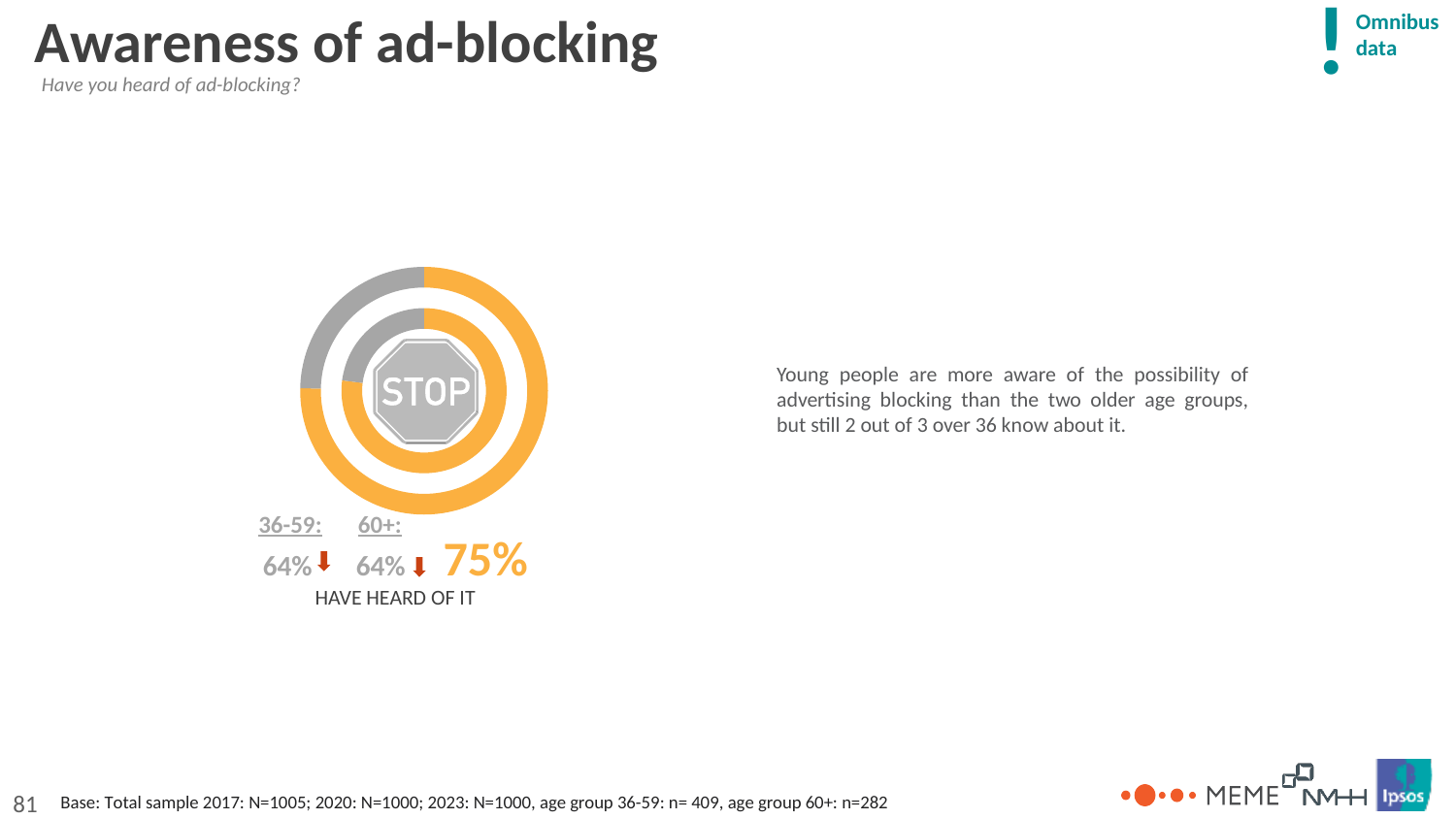
What kind of chart is used to show awareness of ad-blocking? Doughnut (ring) chart Do the 36-59 and 60+ age groups have the same awareness percentage? Yes, both 64% What symbol is shown in the centre of the ring chart? A STOP sign What percentage of the 36-59 age group have heard of ad-blocking? 64% What text appears directly below the percentages under the chart? HAVE HEARD OF IT What is the large orange percentage shown beneath the ring chart? 75% What is the difference in percentage points between the 75% figure and the 60+ age group's 64%? 11 percentage points What percentage of the 60+ age group have heard of ad-blocking? 64% What two colours are used for the rings in the chart? Orange and grey Which is larger: the 75% figure or the 36-59 age group's 64%? 75% How many concentric rings does the chart contain? 3